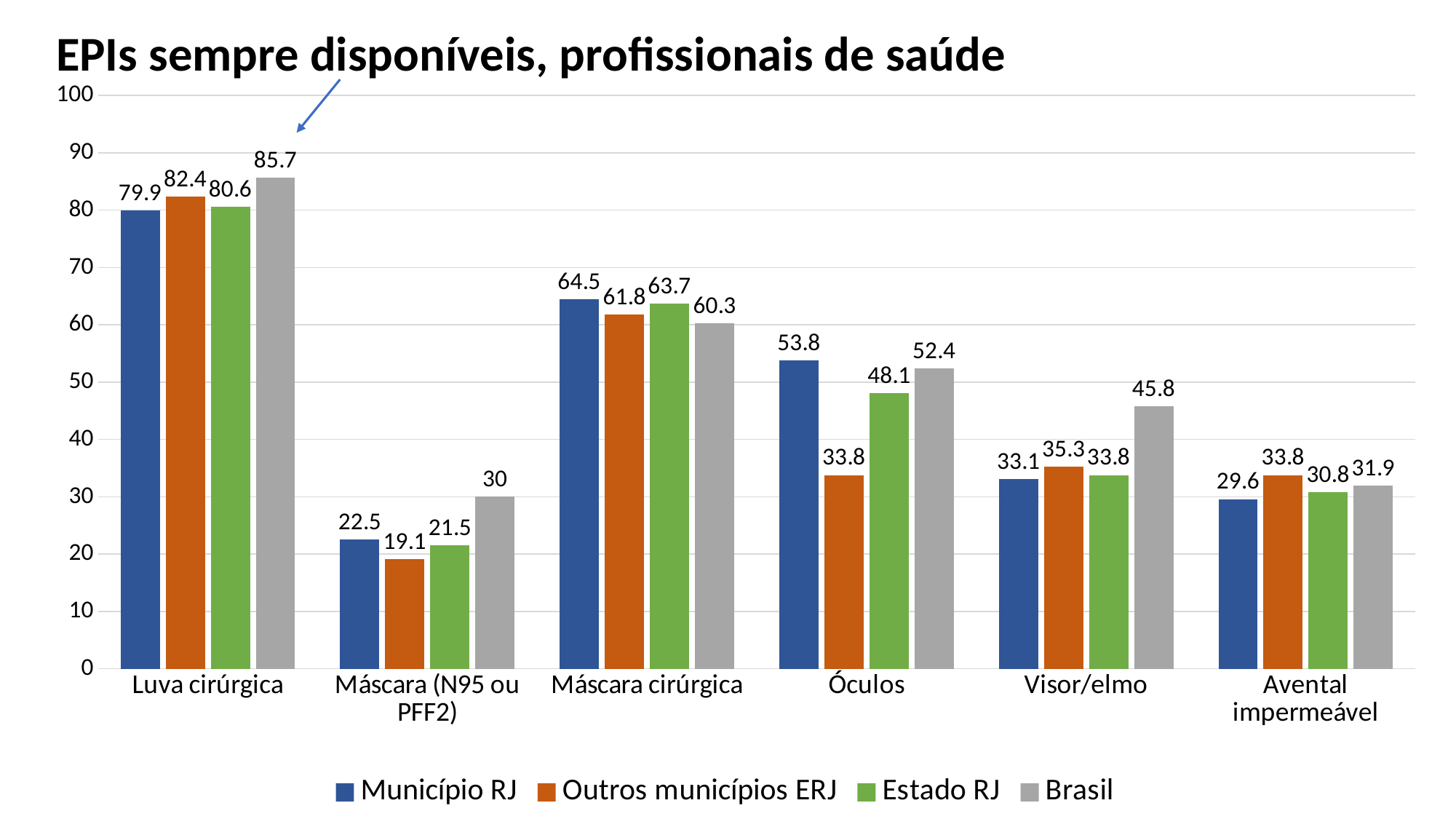
In the Óculos category, which is larger: Município RJ or Outros municípios ERJ? Município RJ Which category has the highest value for Município RJ? Luva cirúrgica What is the difference between the Brasil and Município RJ values in the Visor/elmo category? 12.7 What is the value for Brasil in the Luva cirúrgica category? 85.7 What is the value for Município RJ in the Óculos category? 53.8 What is the title of the chart? EPIs sempre disponíveis, profissionais de saúde Which category has the lowest value for Brasil? Máscara (N95 ou PFF2) What kind of chart is shown on the slide? Bar chart How many categories are shown on the x axis? 6 How many series does the legend list? 4 What is the value for Outros municípios ERJ in the Máscara (N95 ou PFF2) category? 19.1 Is the value for Estado RJ in the Máscara cirúrgica category greater or less than 60? greater